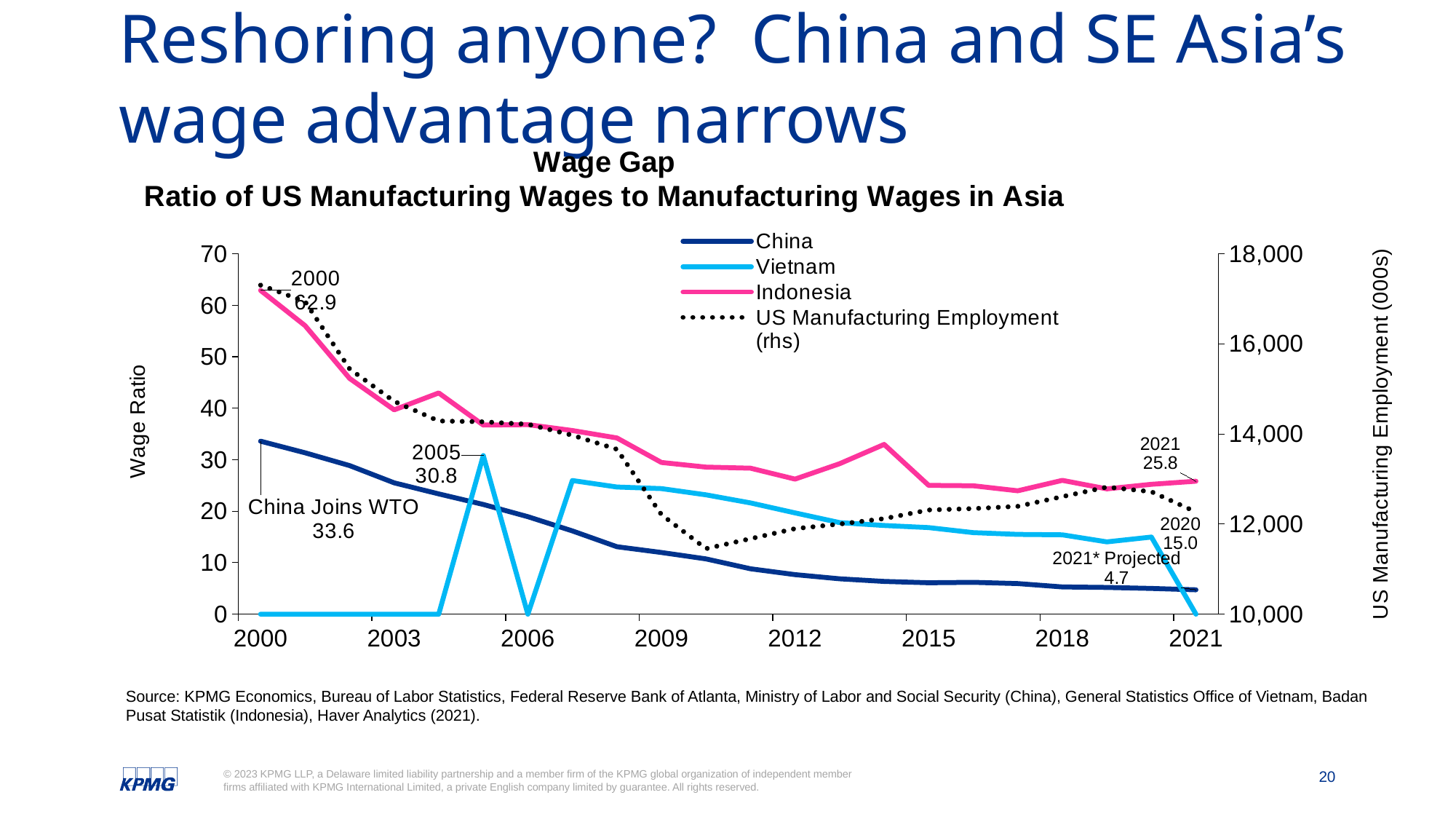
Does the China wage ratio rise or fall from 2000 to 2021? fall What is the wage ratio for Vietnam in 2005? 30.8 Is US Manufacturing Employment in 2000 greater or less than 16,000? greater How many series does the legend list? 4 What kind of chart is shown on the slide? line chart What is the wage ratio for Indonesia in 2021? 25.8 Which is larger: the Indonesia wage ratio in 2021 or the Vietnam wage ratio in 2020? Indonesia in 2021 What is the projected wage ratio for China in 2021? 4.7 What is the wage ratio for China in 2000, when China joins the WTO? 33.6 Which series has the highest wage ratio in 2000? Indonesia By how much did the Indonesia wage ratio fall from 2000 (62.9) to 2021 (25.8)? 37.1 What is the wage ratio for Indonesia in 2000? 62.9